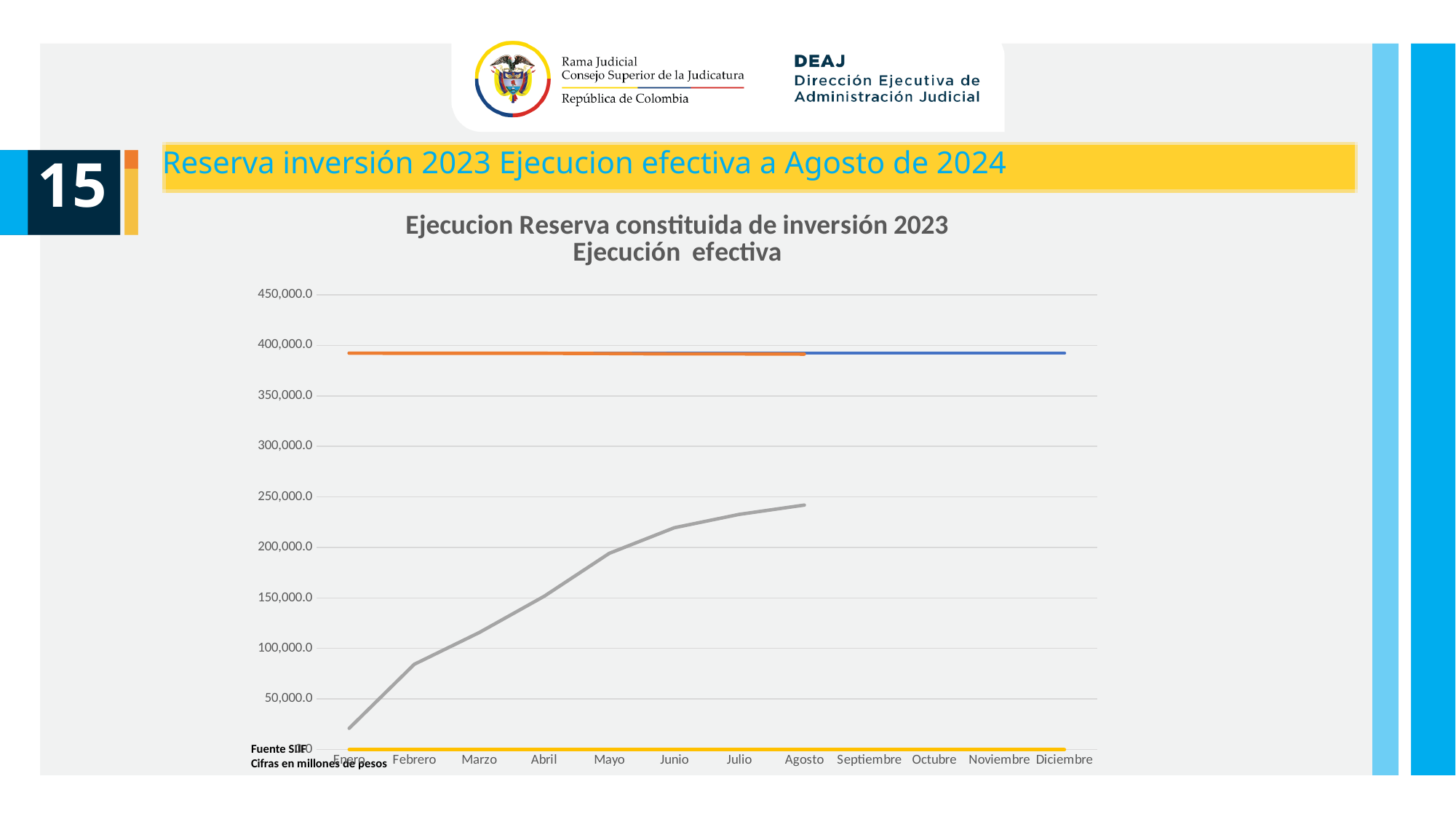
Does the gray line rise or fall from Enero to Agosto? rise In which month does the gray line have its lowest value? Enero Which is larger in Junio, the value of the orange line or the value of the gray line? the orange line Is the value of the orange line in Abril greater or less than 400,000.0? less Is the value of the orange line in Enero greater or less than 350,000.0? greater Is the value of the gray line in Enero greater or less than 50,000.0? less What kind of chart is shown on the slide? line chart In which month does the gray line reach its highest value? Agosto How many months are labelled along the x axis of the chart? 12 What is the title of the chart? Ejecucion Reserva constituida de inversión 2023 Ejecución efectiva